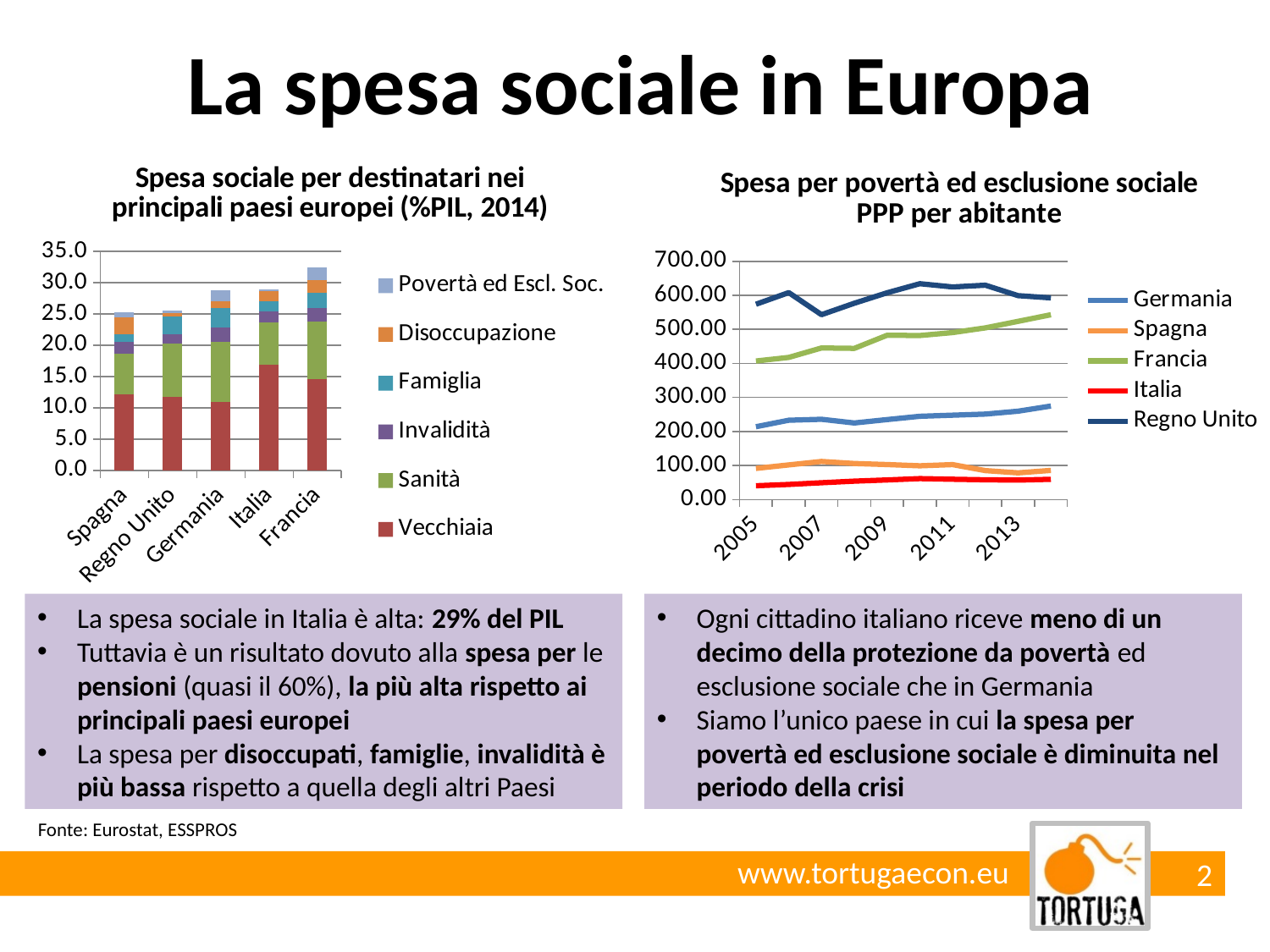
In the left chart, how many countries are shown on the x axis? 5 In the right chart, how many countries does the legend list? 5 In the right chart, which country has the highest spending across the period? Regno Unito In the left chart, which country has the highest total social spending? Francia What kind of chart is the left chart, 'Spesa sociale per destinatari nei principali paesi europei (%PIL, 2014)'? Stacked bar chart In the right chart, which country has the lowest spending across the period? Italia What kind of chart is the right chart, 'Spesa per povertà ed esclusione sociale PPP per abitante'? Line chart In the left chart, is the total for Spagna greater or less than 30? less In the left chart, is the total for Francia greater or less than 30? greater In the left chart, which country has the largest 'Vecchiaia' segment? Italia In the left chart, how many series does the legend list? 6